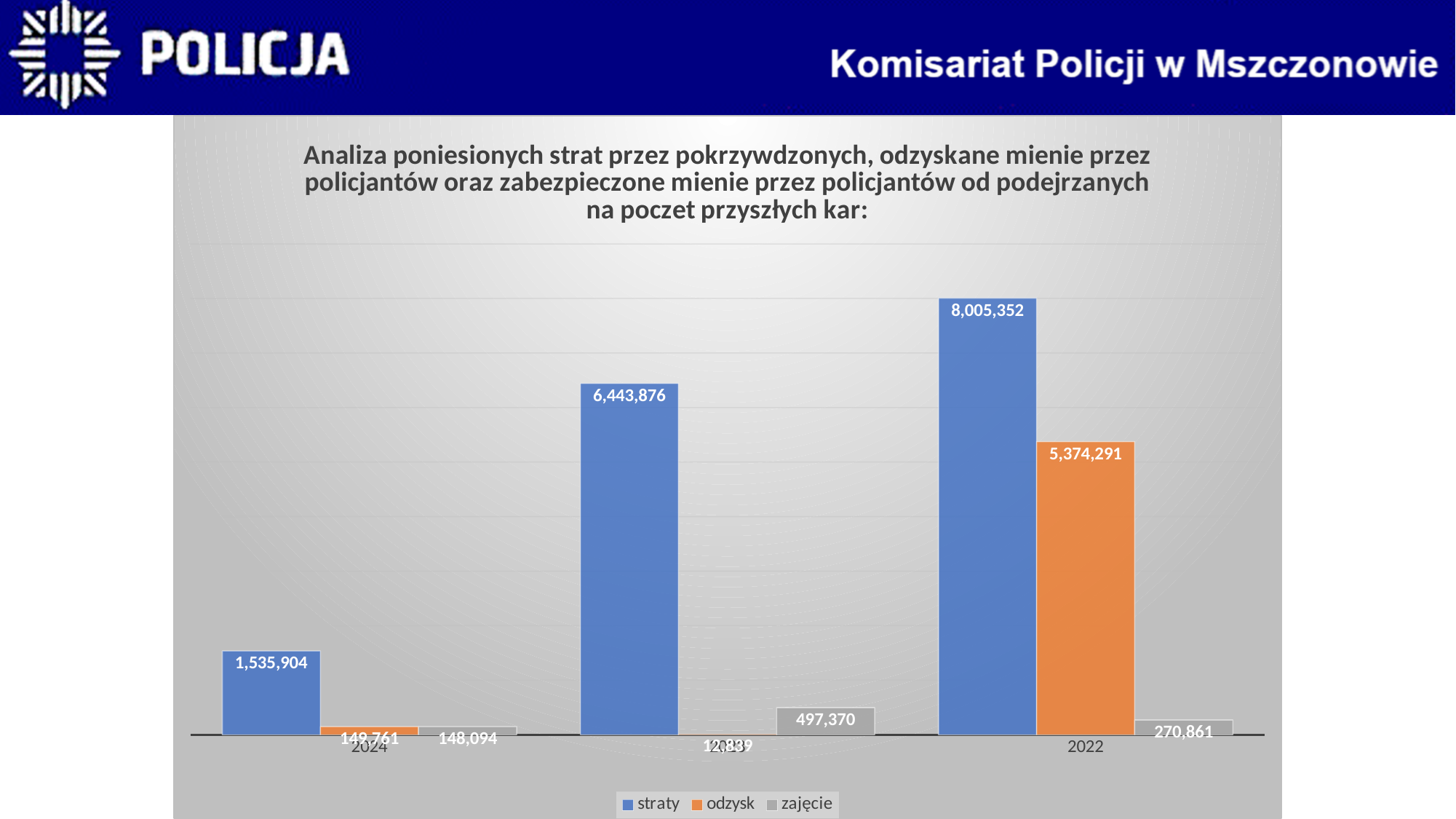
How many series does the legend list? 3 What is the difference between straty in 2022 and straty in 2023? 1,561,476 What is the value of straty for 2023? 6,443,876 What is the value of straty for 2022? 8,005,352 What is the value of straty for 2024? 1,535,904 Which series is shown in orange in the legend? odzysk Which year has the highest straty value? 2022 What is the value of zajęcie for 2023? 497,370 What type of chart is shown on the slide? bar chart How many year categories are shown on the x axis? 3 What is the value of zajęcie for 2022? 270,861 What is the value of odzysk for 2022? 5,374,291